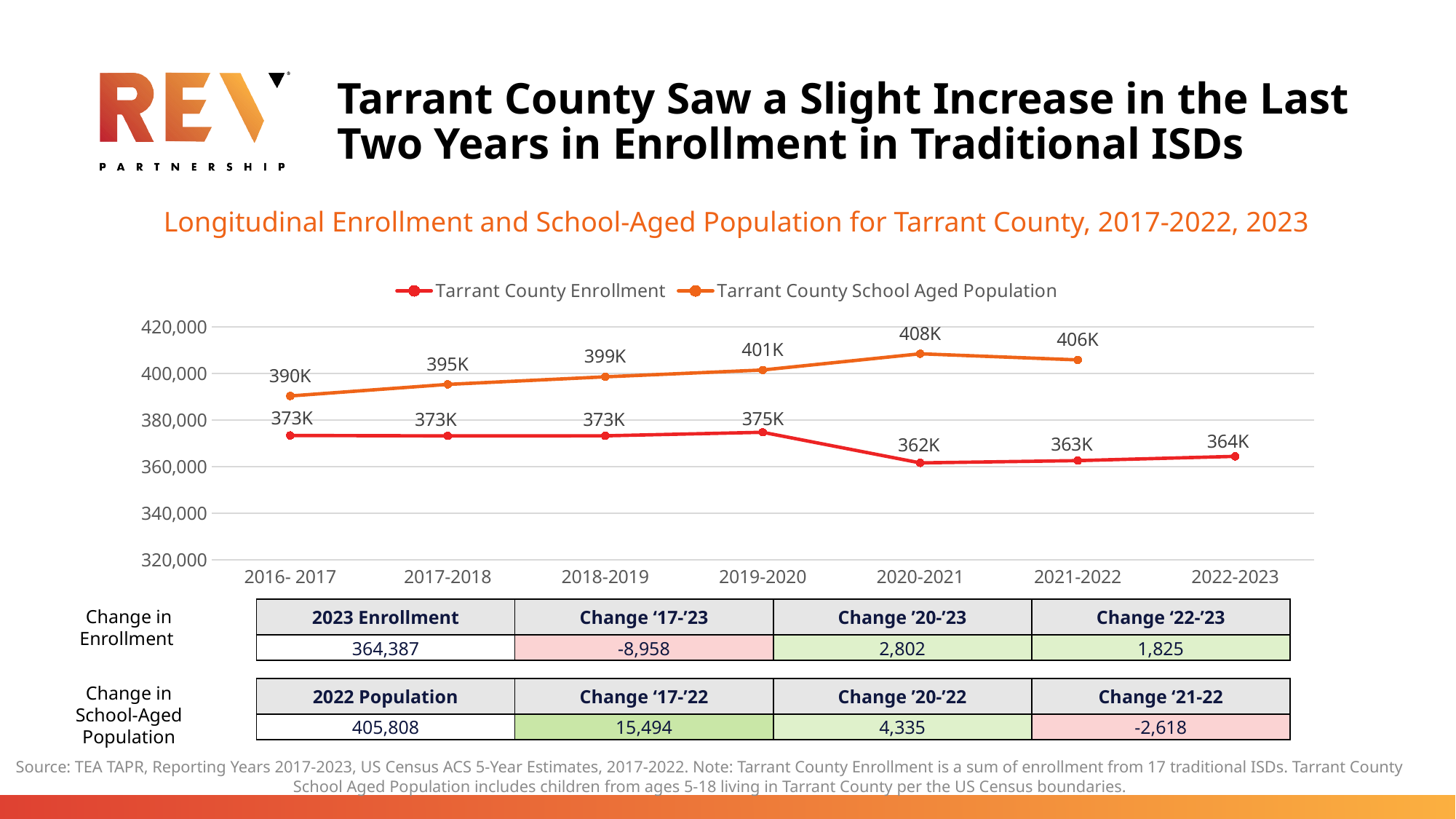
How many school years are shown on the x axis of the chart? 7 Does Tarrant County School Aged Population rise or fall from 2016-2017 to 2020-2021? rise What is the Tarrant County Enrollment value for 2019-2020? 375K How many series does the chart legend list? 2 Which is larger in 2021-2022: Tarrant County Enrollment or Tarrant County School Aged Population? Tarrant County School Aged Population In which school year is Tarrant County Enrollment lowest? 2020-2021 What type of chart is shown on the slide? line chart Is the Tarrant County Enrollment value for 2020-2021 greater or less than 380,000? less What is the Tarrant County School Aged Population value for 2016-2017? 390K What is the Tarrant County Enrollment value for 2022-2023? 364K In which school year is Tarrant County School Aged Population highest? 2020-2021 What is the Tarrant County School Aged Population value for 2020-2021? 408K